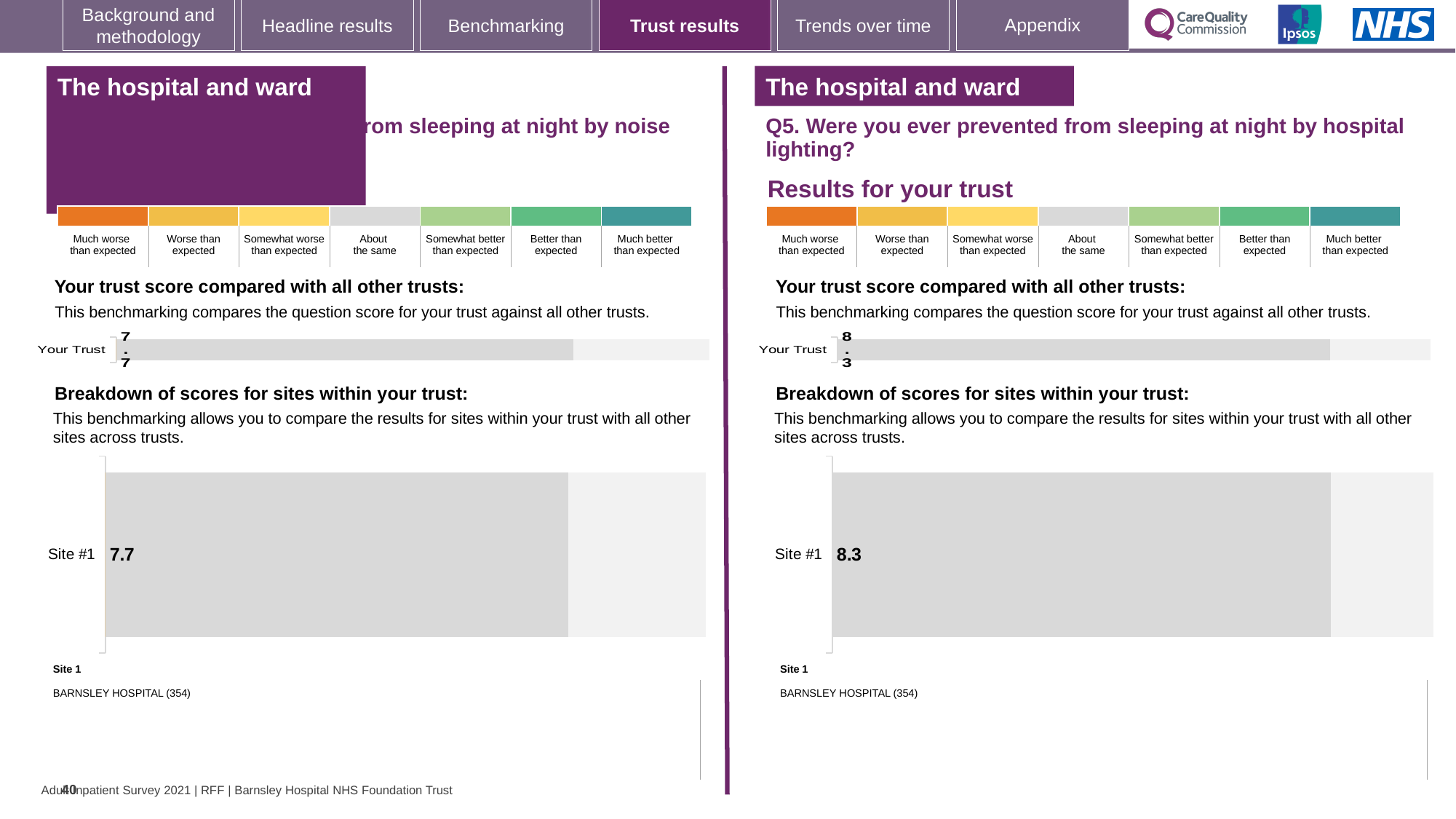
What is the difference between the Your Trust score on the right half (8.3) and the Your Trust score on the left half (7.7)? 0.6 On the left half of the slide (sleeping at night by noise), what score is shown for Site #1 in the breakdown of scores for sites? 7.7 On the right half of the slide (Q5, hospital lighting), what score is shown for Site #1 in the breakdown of scores for sites? 8.3 Which hospital is listed as Site 1 beneath the breakdown charts? BARNSLEY HOSPITAL (354) Which Site #1 score is larger: the one on the left chart (noise) or the one on the right chart (hospital lighting)? the right chart (hospital lighting), 8.3 What is the label of the leftmost (orange) band in the colour scale above the charts on the right half of the slide? Much worse than expected What kind of chart is used to show the Site #1 score on the left half of the slide? bar chart On the left half of the slide (sleeping at night by noise), what is the score shown for Your Trust? 7.7 On the right half of the slide (Q5, hospital lighting), what is the score shown for Your Trust? 8.3 How many sites are shown in the breakdown of scores for sites chart on the right half of the slide? 1